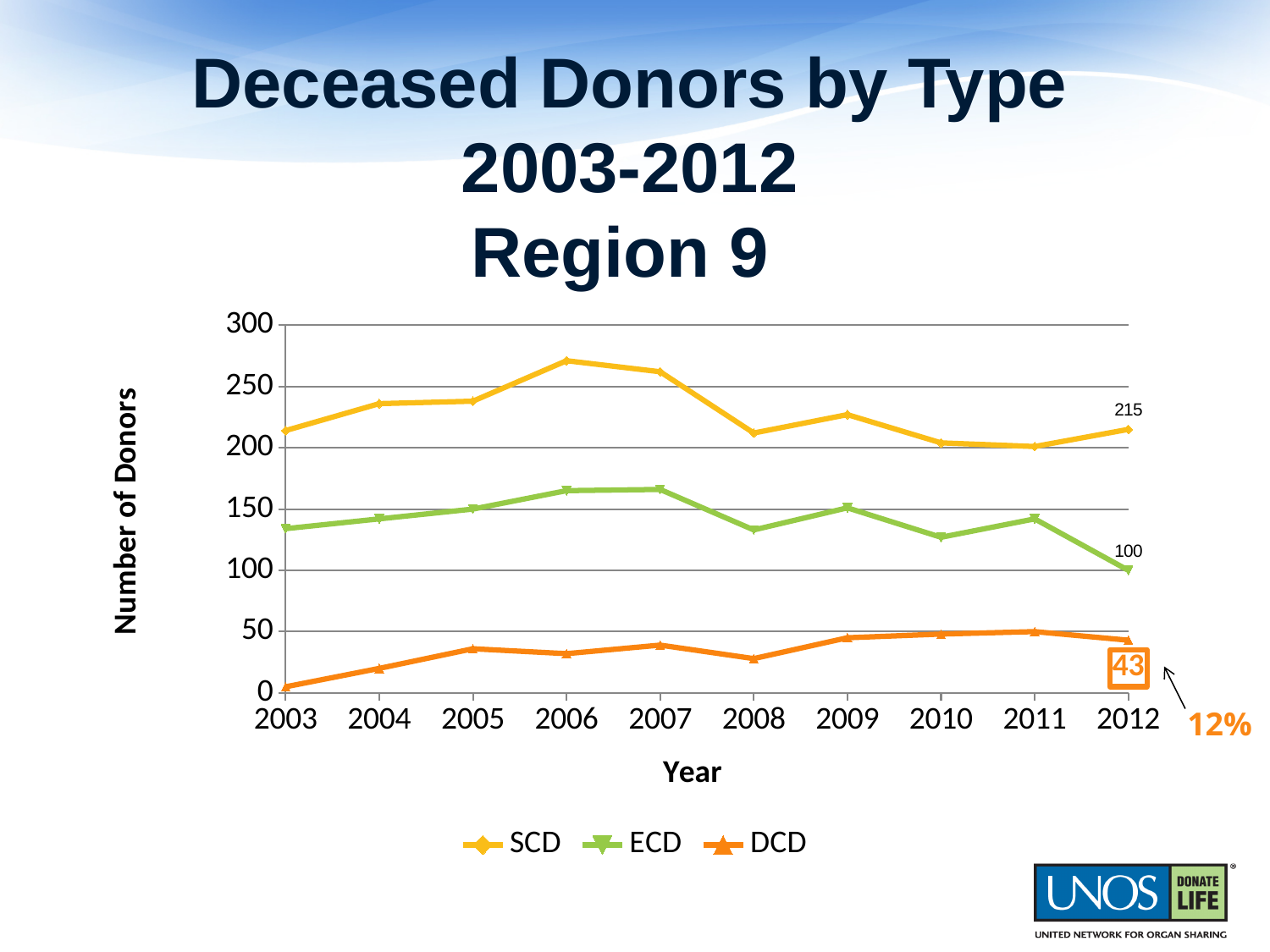
Is the value for ECD in 2010 greater or less than 150? less In which year is the DCD series at its lowest? 2003 What is the value for DCD in 2012? 43 What is the difference between the SCD and ECD values in 2012? 115 Is the value for SCD in 2006 greater or less than 250? greater In which year is the SCD series at its highest? 2006 What is the value for ECD in 2012? 100 What kind of chart is shown on the slide? line chart What is the value for SCD in 2012? 215 Which series has the larger value in 2012, ECD or DCD? ECD How many series does the legend list? 3 How many years are shown on the x axis? 10